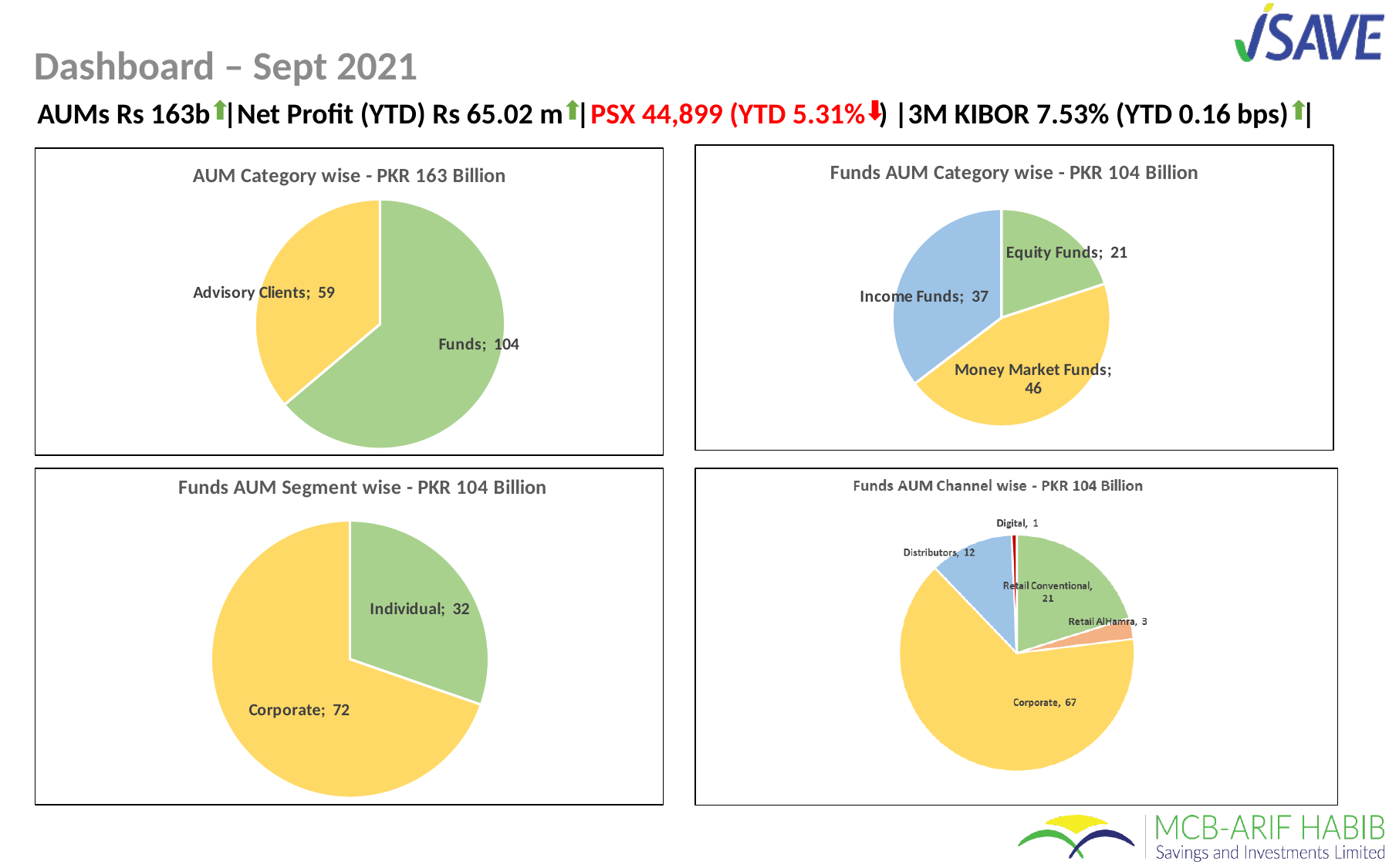
In the 'Funds AUM Segment wise - PKR 104 Billion' chart, which is larger, Individual or Corporate? Corporate In the 'AUM Category wise - PKR 163 Billion' chart, what is the difference between Funds and Advisory Clients? 45 In the 'Funds AUM Category wise - PKR 104 Billion' chart, which category is the largest? Money Market Funds In the 'Funds AUM Channel wise - PKR 104 Billion' chart, what is the value for Distributors? 12 In the 'Funds AUM Category wise - PKR 104 Billion' chart, which category is the smallest? Equity Funds In the 'Funds AUM Category wise - PKR 104 Billion' chart, what is the value for Income Funds? 37 How many categories are shown in the 'Funds AUM Category wise - PKR 104 Billion' chart? 3 In the 'AUM Category wise - PKR 163 Billion' chart, what is the value for Funds? 104 In the 'Funds AUM Channel wise - PKR 104 Billion' chart, which channel has the smallest value? Digital In the 'Funds AUM Segment wise - PKR 104 Billion' chart, what is the value for Corporate? 72 What type of chart is the 'Funds AUM Channel wise - PKR 104 Billion' chart? Pie chart In the 'AUM Category wise - PKR 163 Billion' chart, what is the value for Advisory Clients? 59